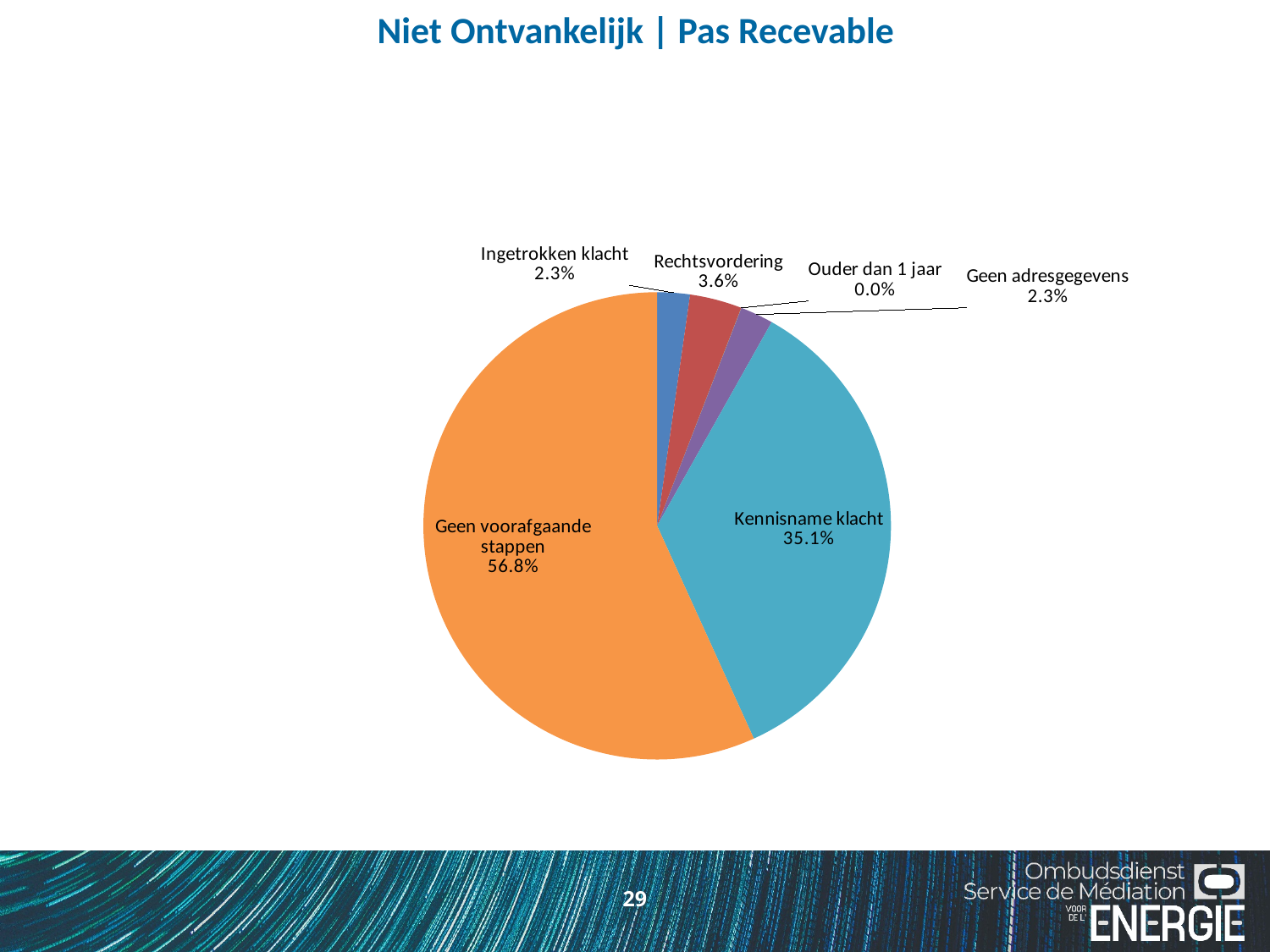
How many categories are shown in the pie chart? 6 What is the value shown for Rechtsvordering? 3.6% What share of the pie does Kennisname klacht represent? 35.1% What is the value shown for Geen adresgegevens? 2.3% What is the difference in percentage points between Geen voorafgaande stappen and Kennisname klacht? 21.7 percentage points What type of chart is shown on the slide? Pie chart Which category has the largest slice of the pie? Geen voorafgaande stappen What share of the pie does Geen voorafgaande stappen represent? 56.8% Which is larger, Rechtsvordering or Ingetrokken klacht? Rechtsvordering What is the value shown for Ouder dan 1 jaar? 0.0% What is the title of the chart on the slide? Niet Ontvankelijk | Pas Recevable Which category has the smallest slice of the pie? Ouder dan 1 jaar